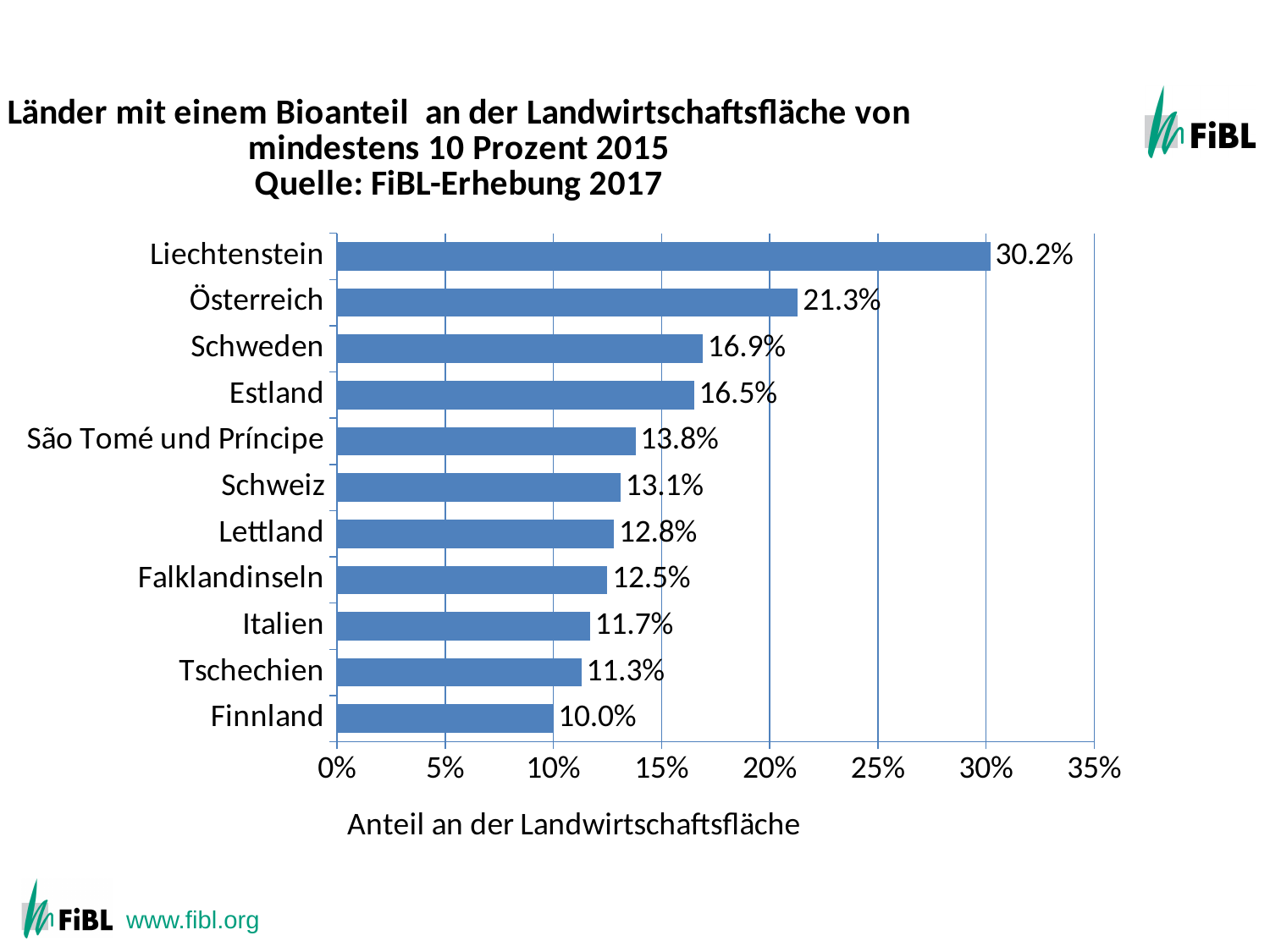
What is the difference between the values for Schweden and Estland? 0.4% What is the value for Finnland? 10.0% What value is shown for São Tomé und Príncipe? 13.8% Which has a larger value, Schweiz or Italien? Schweiz Which country has the highest organic share of agricultural land? Liechtenstein What is the label of the horizontal axis? Anteil an der Landwirtschaftsfläche Which country has the lowest value in the chart? Finnland How many countries are shown in the chart? 11 What is the organic share of agricultural land for Österreich? 21.3% What kind of chart is shown on the slide? Bar chart What is the difference between the values for Liechtenstein and Österreich? 8.9% Is the value for Lettland greater or less than 15%? less